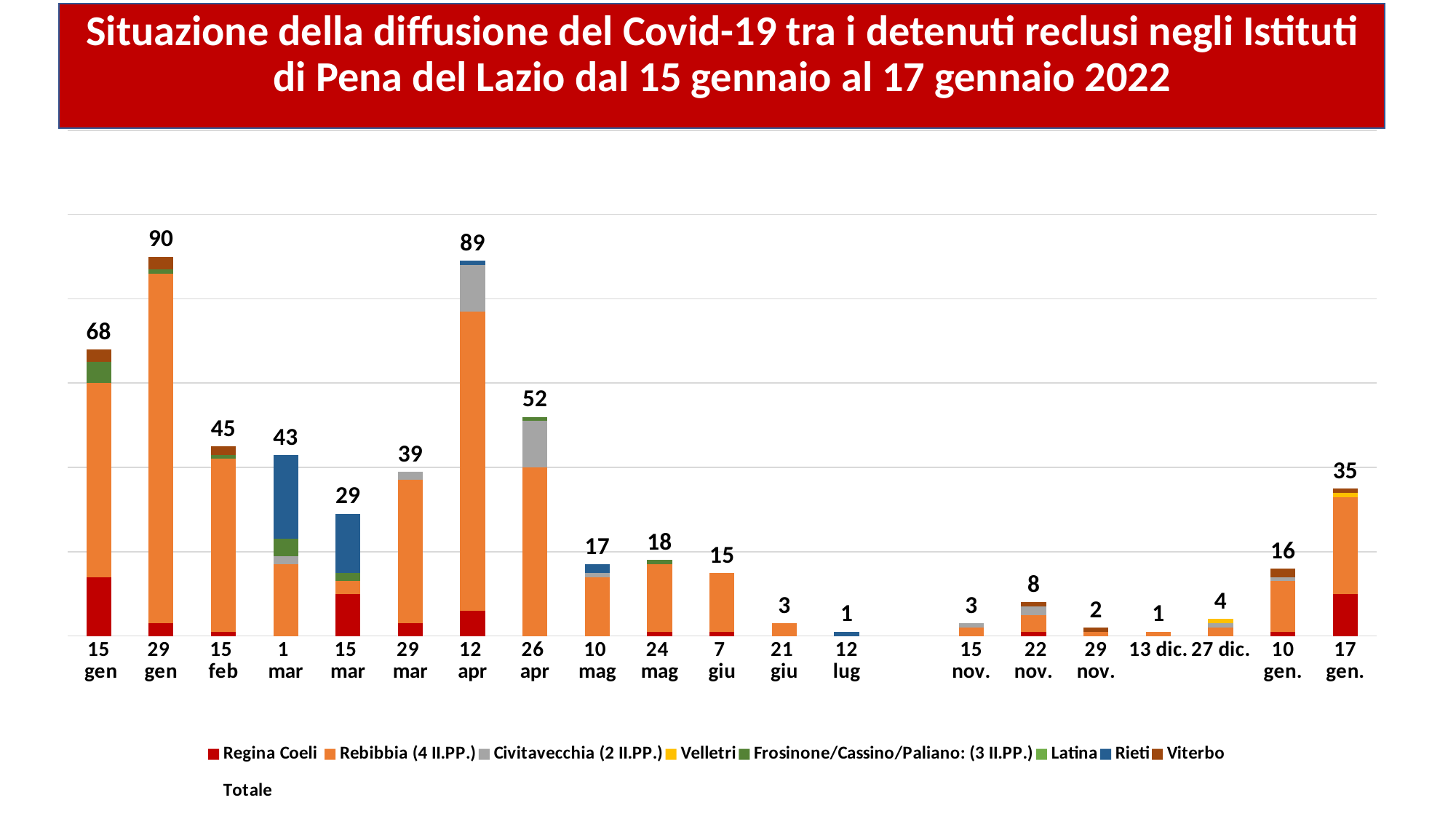
How many dates are shown along the x axis? 20 What is the total number of cases shown for 29 gen? 90 Which date has the highest total? 29 gen Which has a larger total, 10 gen. or 17 gen.? 17 gen. Which has a larger total, 10 mag or 24 mag? 24 mag What is the lowest total value labelled on the chart? 1 Do the totals rise or fall from 12 apr to 12 lug? Fall What kind of chart is shown on the slide? Stacked bar chart What is the total value labelled above the bar for 12 apr? 89 What is the total value shown for 17 gen.? 35 What is the difference between the totals for 12 apr and 26 apr? 37 What is the difference between the totals for 29 gen and 15 gen? 22